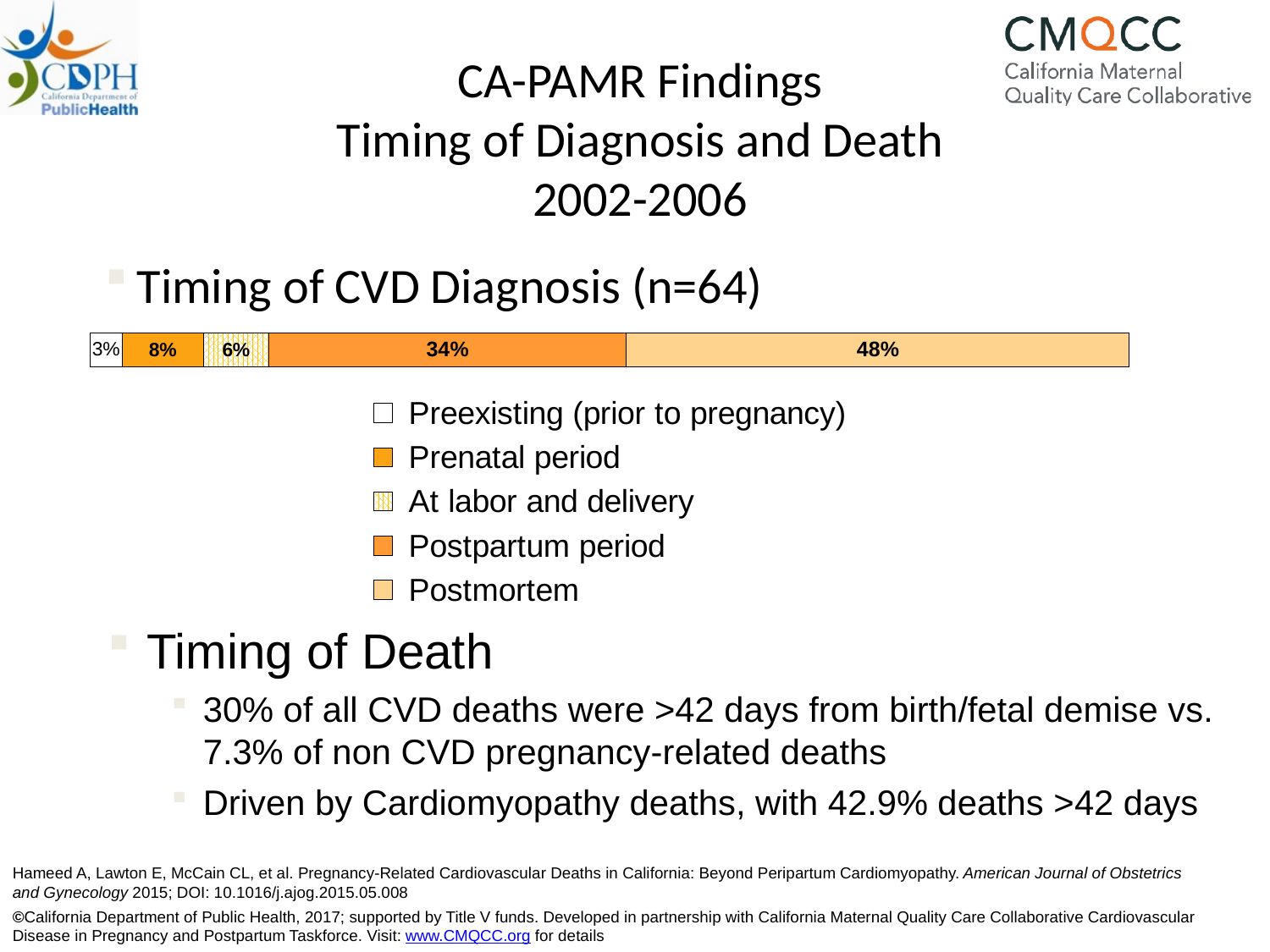
What percentage of CVD diagnoses were preexisting (prior to pregnancy)? 3% Which timing category accounts for the largest share of CVD diagnoses? Postmortem How many timing categories does the legend list? 5 What percentage of CVD diagnoses were made in the prenatal period? 8% Which timing category accounts for the smallest share of CVD diagnoses? Preexisting (prior to pregnancy) What percentage of CVD diagnoses were made at labor and delivery? 6% What percentage of CVD diagnoses were made postmortem? 48% What percentage of CVD diagnoses were made in the postpartum period? 34% What kind of chart is used to show the timing of CVD diagnosis? Stacked bar chart Which is larger, the share of diagnoses in the prenatal period or at labor and delivery? Prenatal period What is the sample size (n) stated for the timing of CVD diagnosis chart? 64 What is the difference in percentage points between postmortem and postpartum period diagnoses? 14